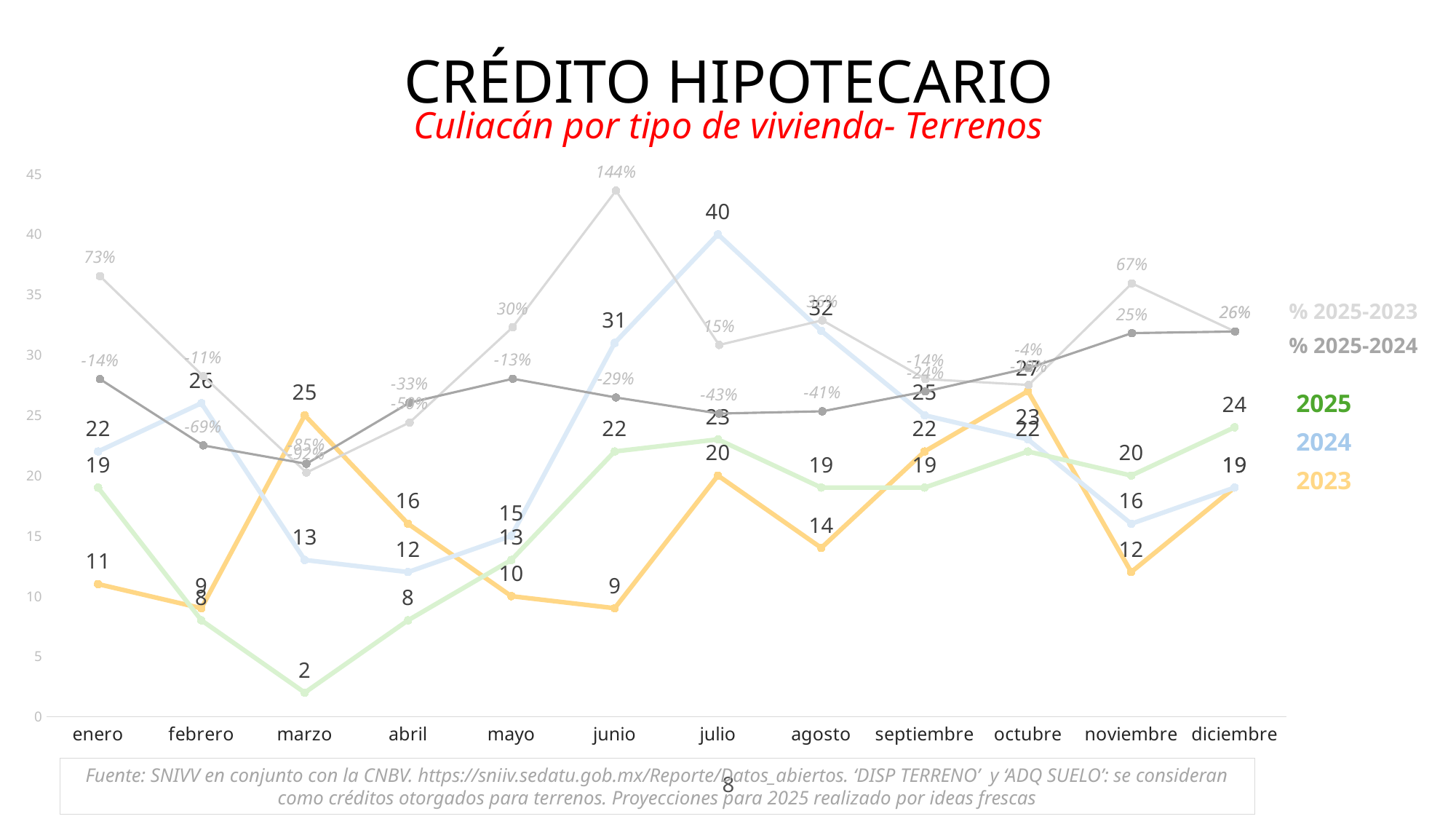
In which month does the 2024 series reach its highest value? julio In which month does the 2025 series have its lowest value? marzo What is the value for 2023 in marzo? 25 What is the value for 2025 in diciembre? 24 What is the % 2025-2023 value shown for junio? 144% What is the red subtitle of the chart? Culiacán por tipo de vivienda- Terrenos What is the value for 2024 in julio? 40 How many months are shown on the x axis? 12 How many series does the legend list? 5 What kind of chart is shown on the slide? line chart In octubre, which series has the larger value, 2023 or 2024? 2023 What is the difference between the 2024 and 2023 values in julio? 20